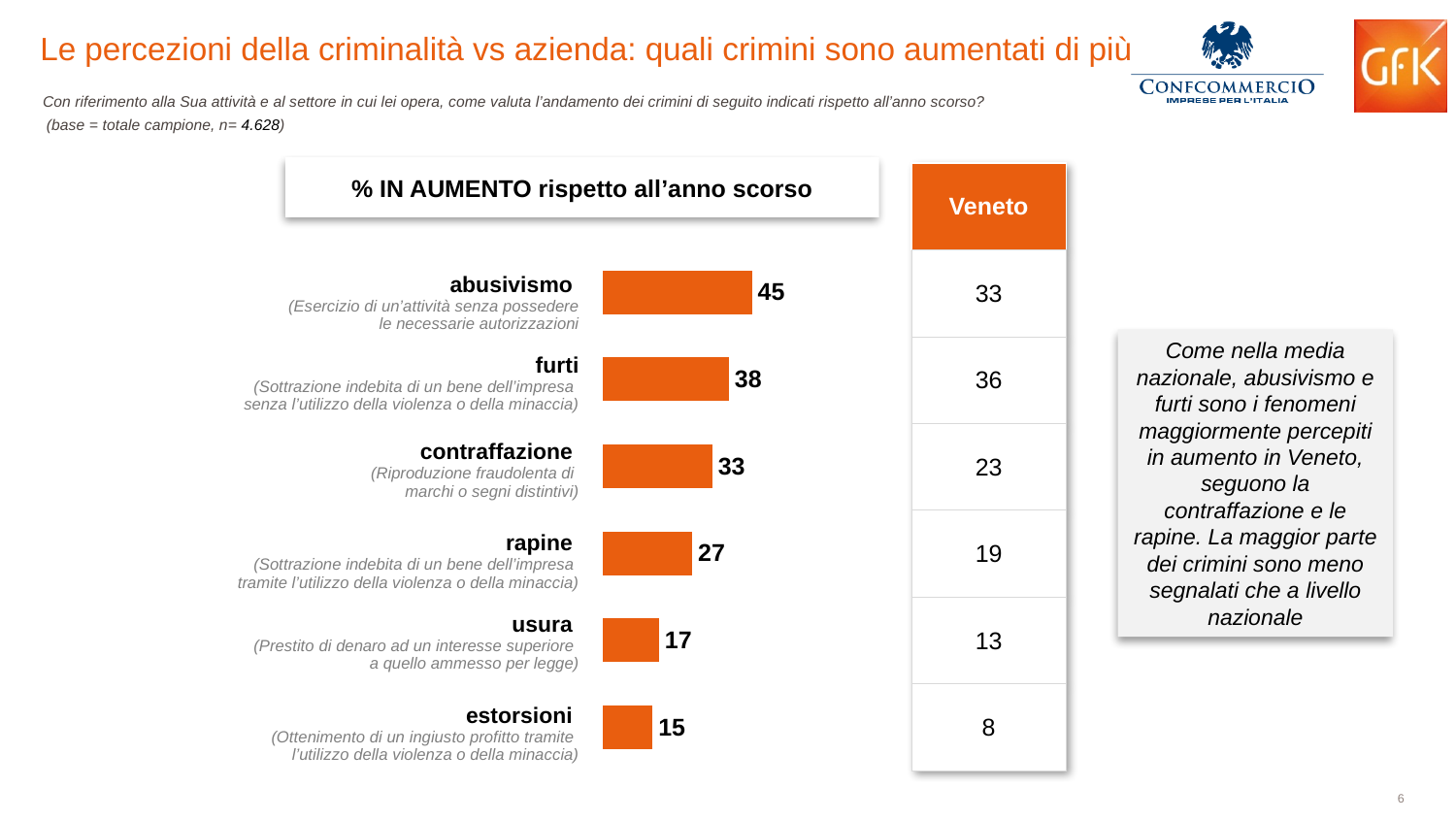
What is the title shown above the bar chart? % IN AUMENTO rispetto all'anno scorso What is the Veneto value shown next to furti in the table? 36 How many categories are shown in the bar chart? 6 Which is larger in the bar chart, the value for furti or the value for rapine? furti What kind of chart is shown on the slide? bar chart Which category has the lowest value in the bar chart? estorsioni What is the value for abusivismo in the bar chart? 45 What is the difference between the values for contraffazione and estorsioni in the bar chart? 18 What is the value for usura in the bar chart? 17 What is the value for rapine in the bar chart? 27 Which category has the highest value in the bar chart? abusivismo What is the difference between the values for abusivismo and furti in the bar chart? 7